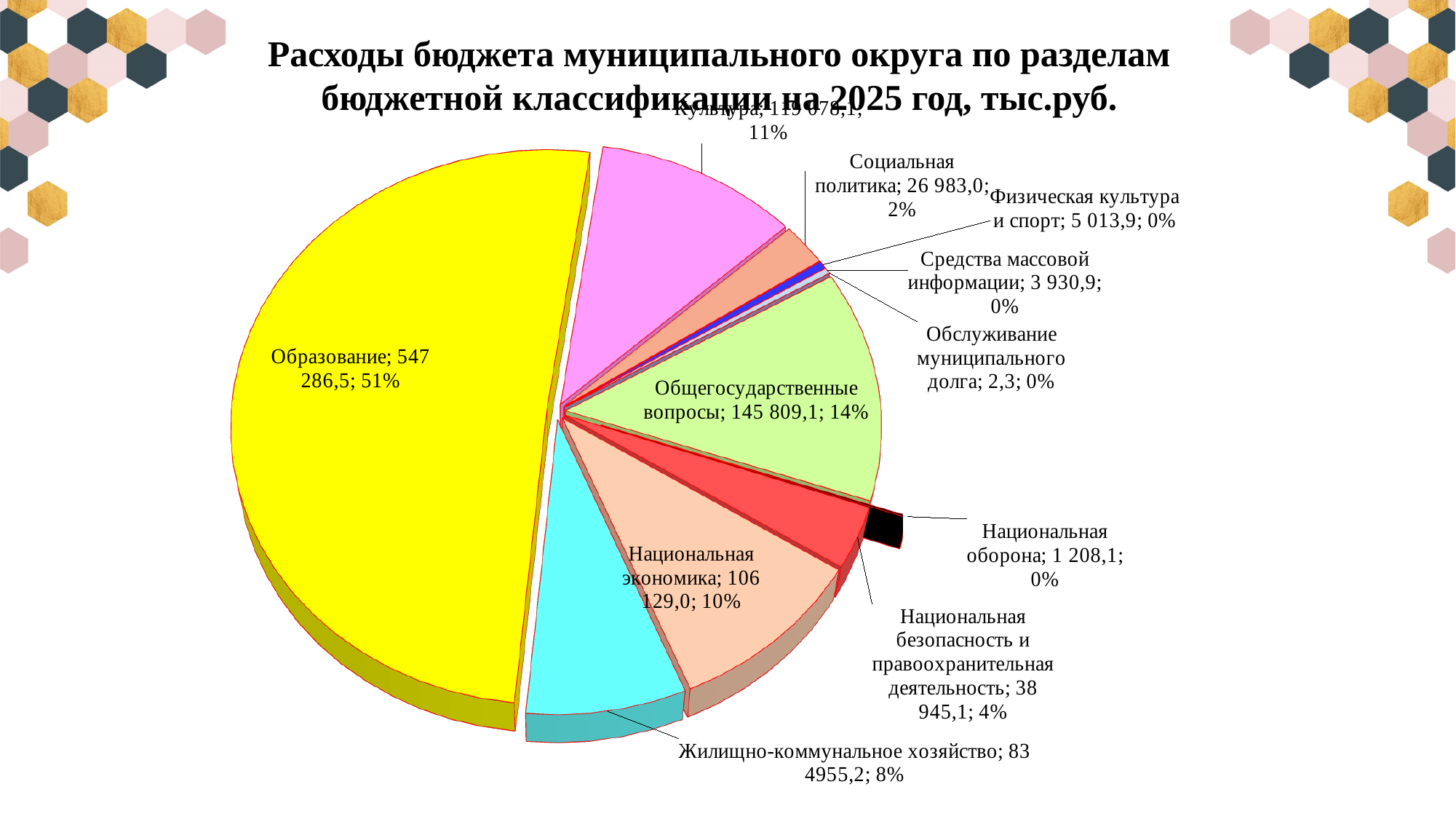
Which category has the largest share of the budget expenditures? Образование What is the value for Образование? 547 286,5 What is the value for Общегосударственные вопросы? 145 809,1 What is the value for Национальная безопасность и правоохранительная деятельность? 38 945,1 What unit of measurement is stated in the chart title? тыс.руб. What share of the pie does Национальная экономика represent? 10% Which category has the smallest value in the pie chart? Обслуживание муниципального долга How many categories (slices) does the pie chart have? 11 What share of the pie does Образование represent? 51% What kind of chart is shown on the slide? Pie chart What is the difference between Общегосударственные вопросы and Национальная экономика? 39 680,1 Which is larger: Социальная политика or Физическая культура и спорт? Социальная политика